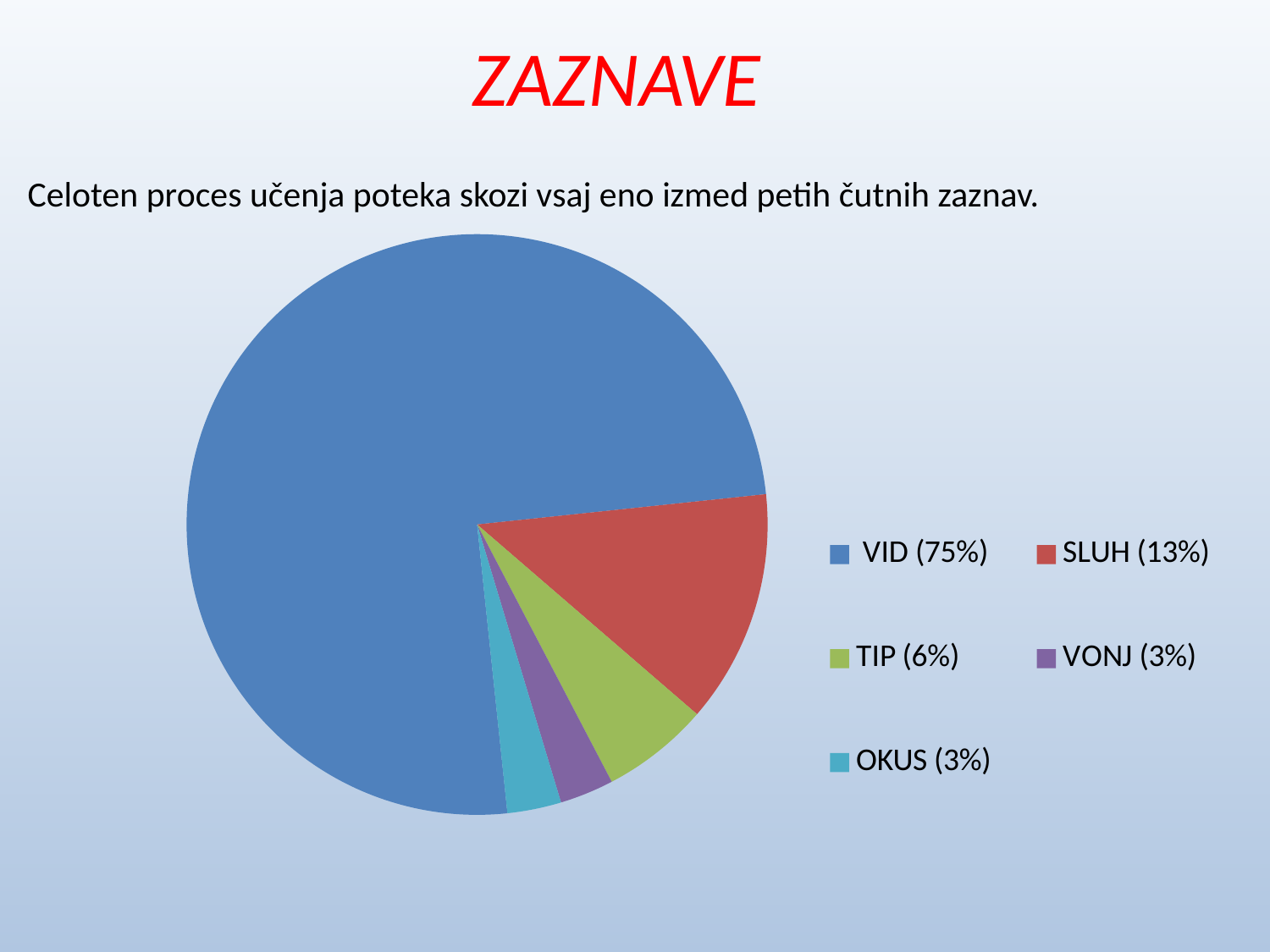
What is the difference in percentage points between VID and SLUH? 62 Which category has the larger slice, SLUH or TIP? SLUH What share of the pie does SLUH take? 13% What share of the pie does VONJ take? 3% What is the difference in percentage points between TIP and OKUS? 3 What kind of chart is shown on the slide? pie chart What share of the pie does VID take? 75% Which category has the largest slice of the pie? VID Which category is shown in red in the legend? SLUH (13%) How many slices does the pie chart have? 5 Which colour is used for the VID slice? blue